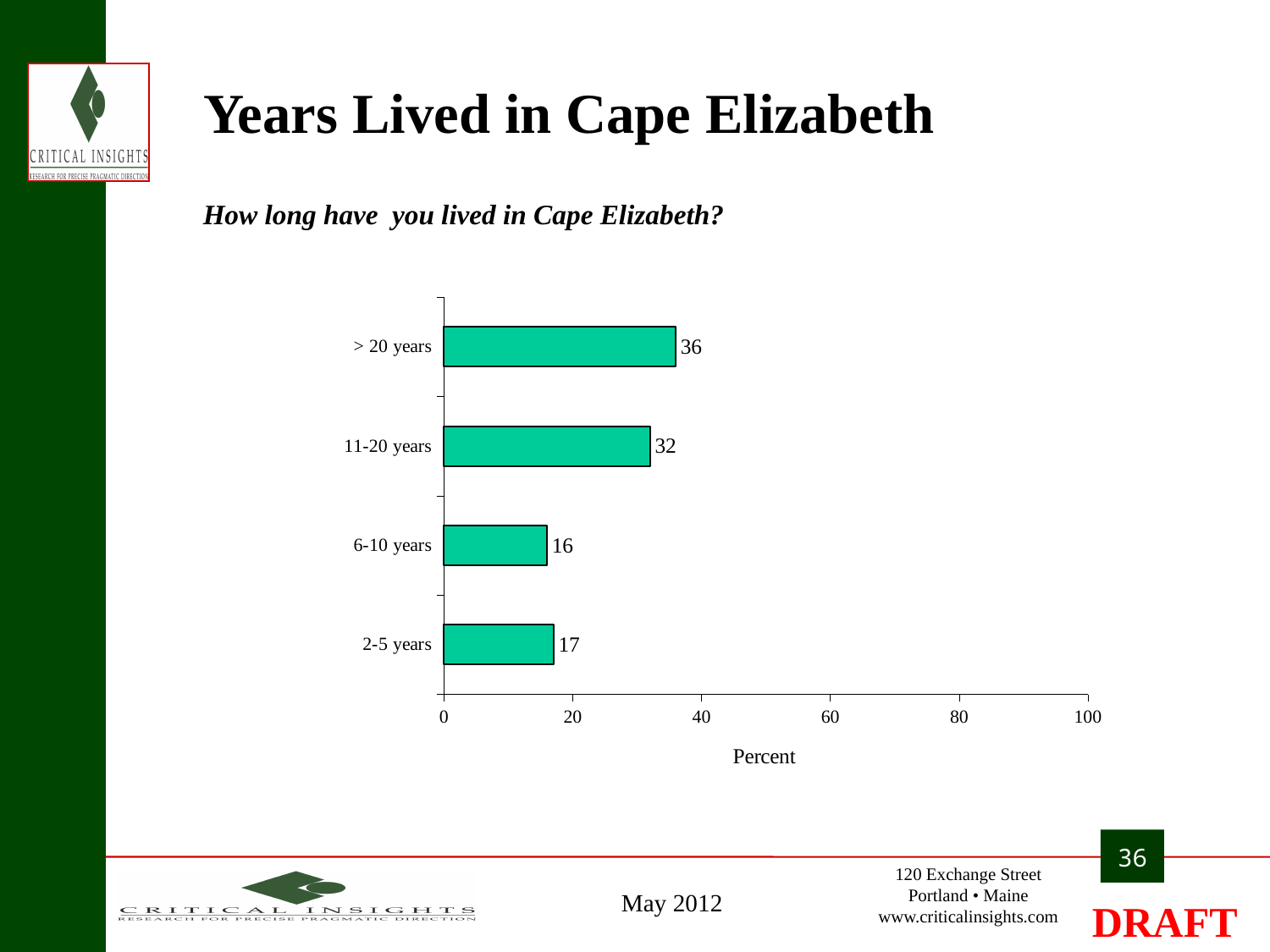
Which is larger, the value for "11-20 years" or the value for "6-10 years"? 11-20 years What is the value for "11-20 years"? 32 What is the value for "> 20 years"? 36 Which category has the lowest value? 6-10 years How many categories are shown in the chart? 4 What is the value for "6-10 years"? 16 What is the difference between the values for "> 20 years" and "11-20 years"? 4 Which category has the highest value? > 20 years Is the value for "> 20 years" greater or less than 20? greater What is the value for "2-5 years"? 17 What kind of chart is shown on the slide? Bar chart What is the label on the horizontal axis of the chart? Percent